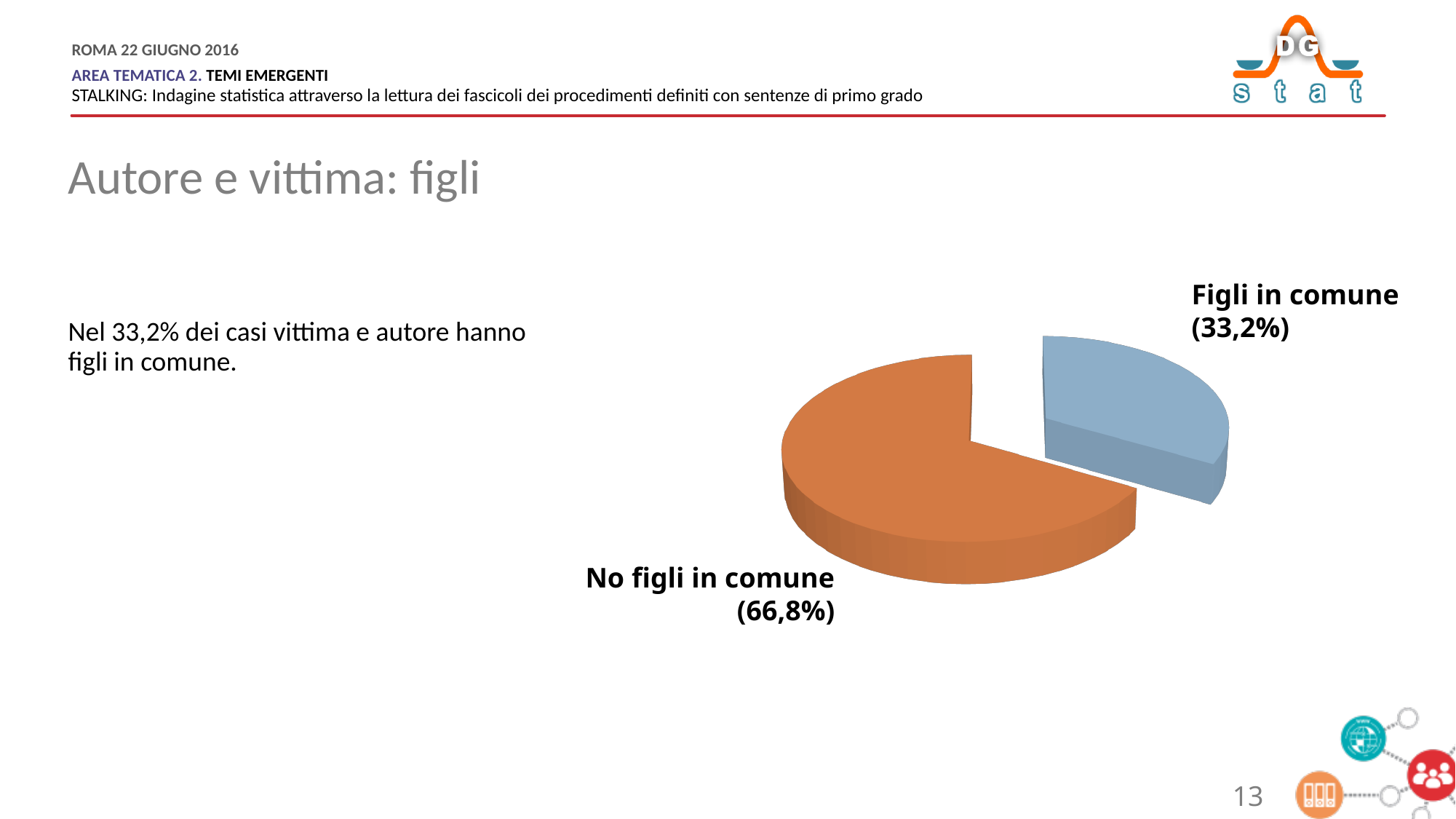
What share of the pie is labelled "No figli in comune"? 66,8% What kind of chart is shown on the slide? pie chart Which slice of the pie is the smallest? Figli in comune What colour is the "No figli in comune" slice? orange How many slices does the pie chart have? 2 What colour is the "Figli in comune" slice? blue Which is larger, the "Figli in comune" slice or the "No figli in comune" slice? No figli in comune Which slice of the pie is the largest? No figli in comune What is the difference in percentage points between the "No figli in comune" slice and the "Figli in comune" slice? 33,6 What share of the pie is labelled "Figli in comune"? 33,2%